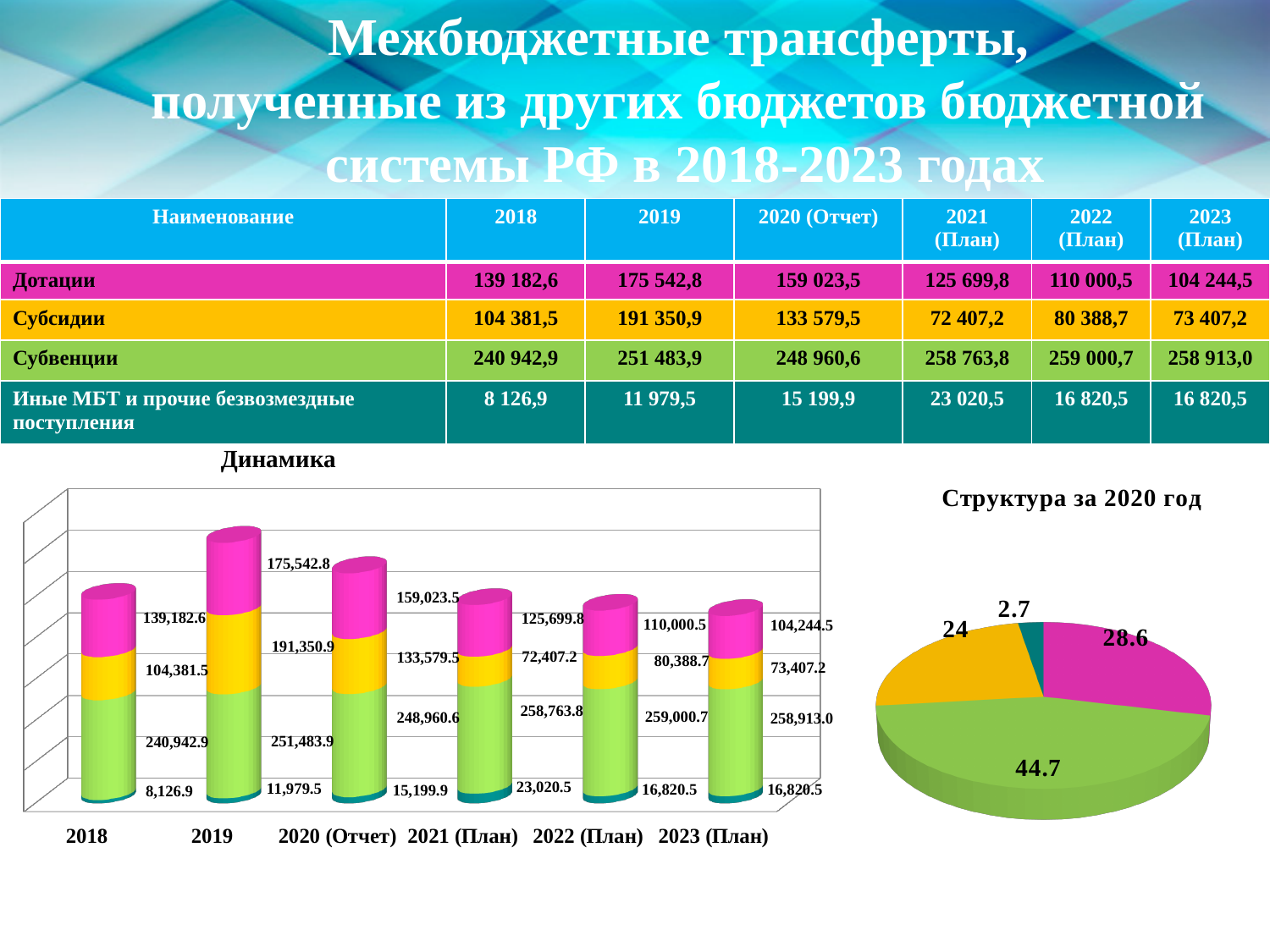
In the "Динамика" chart, what is the value of the pink (top) segment for 2019? 175,542.8 In the "Динамика" chart, what is the value of the green segment for 2022 (План)? 259,000.7 In the "Динамика" chart, what is the difference between the green segment values for 2021 (План) and 2020 (Отчет)? 9,803.2 In the "Динамика" chart, is the yellow segment larger in 2019 or in 2020 (Отчет)? 2019 In the "Динамика" chart, which year has the highest value for the pink (top) segment? 2019 In the "Структура за 2020 год" pie chart, what is the value of the largest slice? 44.7 In the "Структура за 2020 год" pie chart, what is the value of the smallest slice? 2.7 In the "Динамика" chart, how many years (categories) are shown on the x axis? 6 In the "Динамика" chart, which year has the lowest value for the teal (bottom) segment? 2018 What kind of chart is the "Динамика" chart? bar chart What kind of chart is the "Структура за 2020 год" chart? pie chart In the "Динамика" chart, what is the total of the stacked bar for 2018? 492,633.9